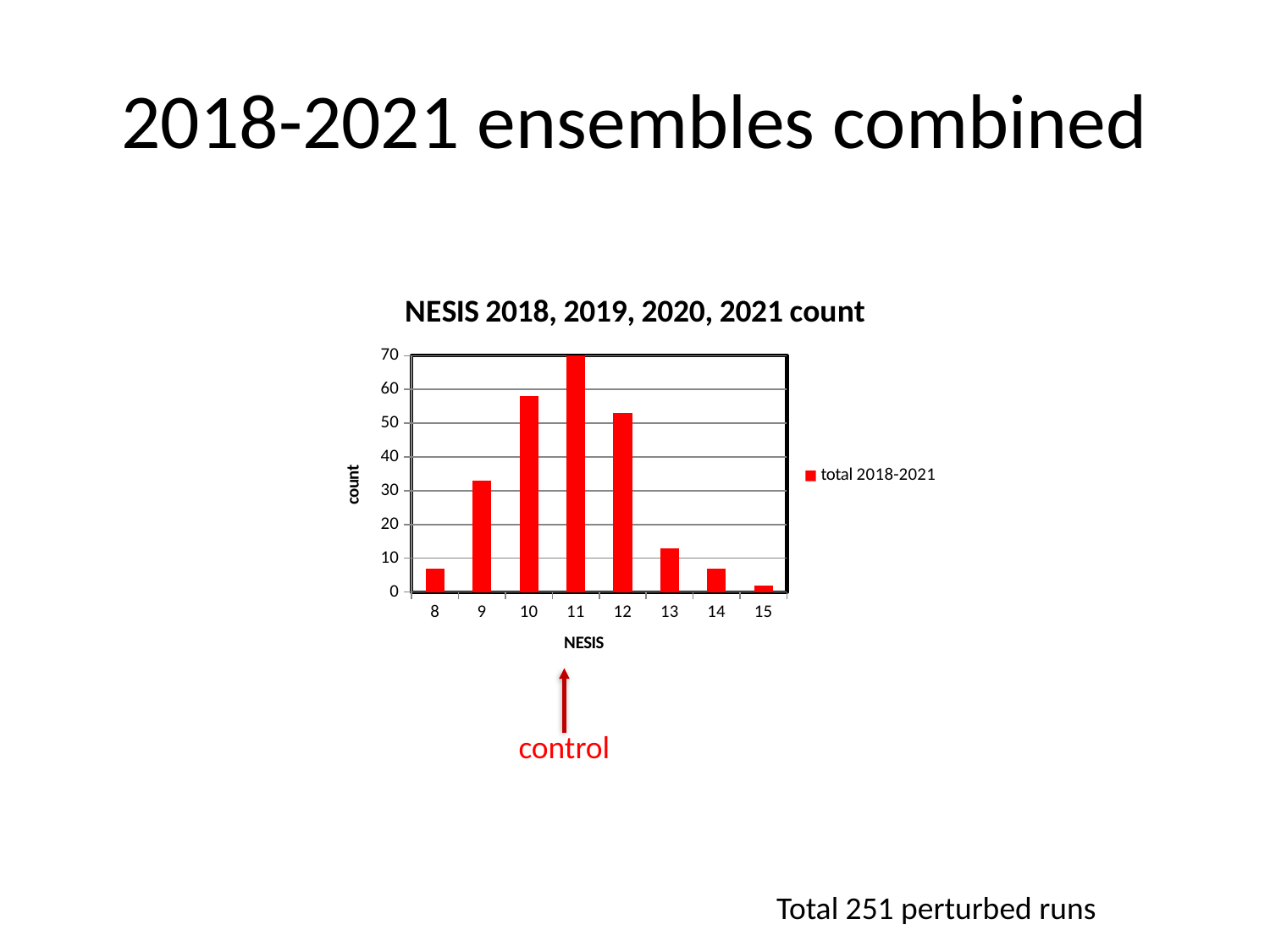
How many NESIS categories are shown on the x axis? 8 What is the title of the chart? NESIS 2018, 2019, 2020, 2021 count Is the count for NESIS 13 greater or less than 10? greater Is the count for NESIS 10 greater or less than 50? greater Which NESIS value has the highest count? 11 Which NESIS value has the lowest count? 15 Is the count for NESIS 9 greater or less than 30? greater What kind of chart is shown on the slide? bar chart Which has a larger count, NESIS 9 or NESIS 12? 12 How many series does the legend list? 1 What is the name of the series shown in the legend? total 2018-2021